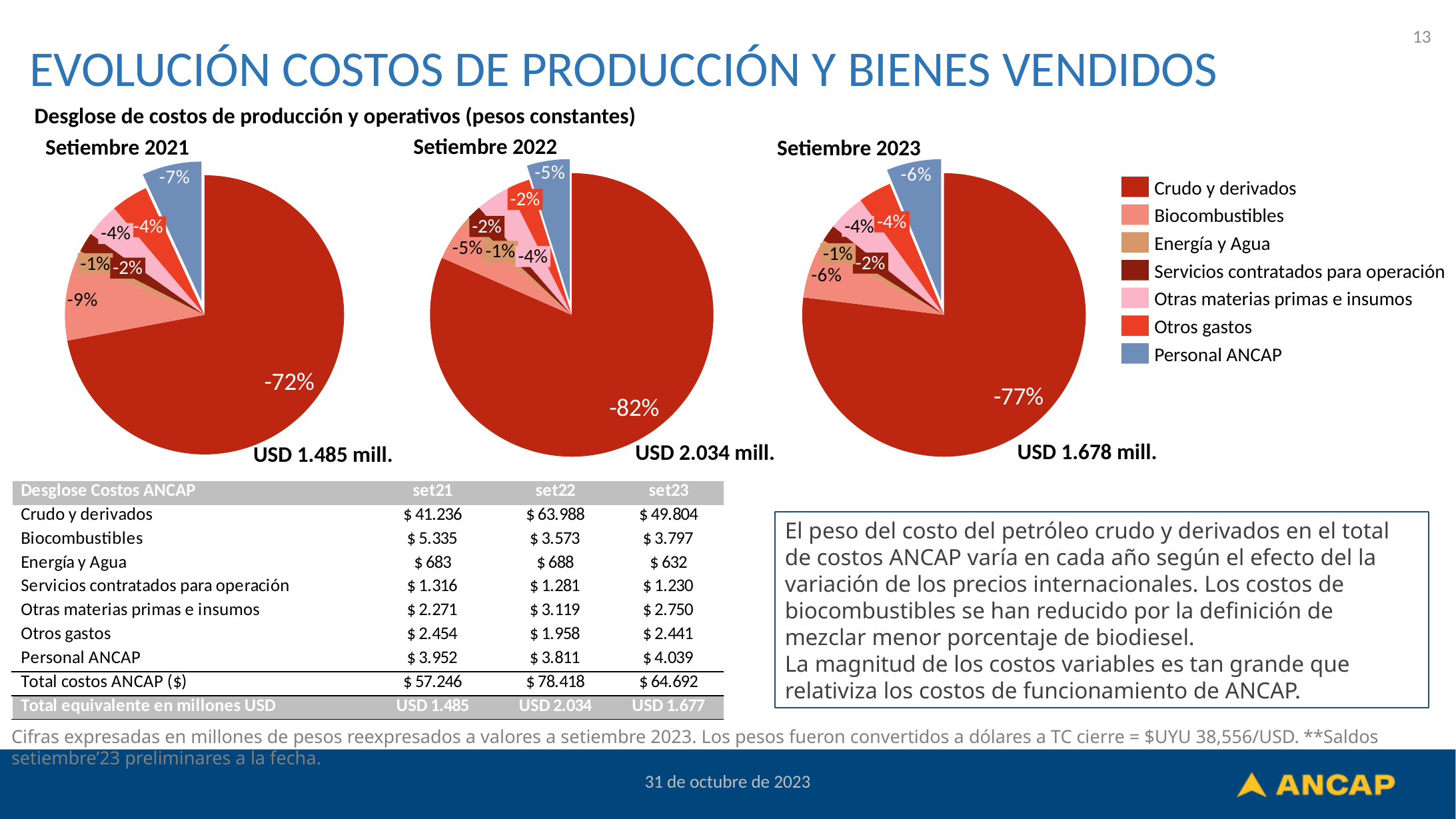
In the Setiembre 2023 pie chart, what percentage label is shown for Personal ANCAP? -6% In the Setiembre 2022 pie chart, what percentage label is shown for Crudo y derivados? -82% In the Setiembre 2021 pie chart, what percentage label is shown for Crudo y derivados? -72% How many categories does the legend list for the pie charts? 7 Which pie chart shows a larger share for Crudo y derivados, Setiembre 2021 or Setiembre 2022? Setiembre 2022 What type of chart is used to show the breakdown of costs for each year? Pie chart What total in USD is shown below the Setiembre 2022 pie chart? USD 2.034 mill. In the Setiembre 2023 pie chart, what percentage label is shown for Crudo y derivados? -77% In the Setiembre 2022 pie chart, which category has the largest slice? Crudo y derivados In the Setiembre 2021 pie chart, which category has the smallest slice? Energía y Agua Which legend category is shown in blue in the pie charts? Personal ANCAP In the Setiembre 2021 pie chart, what percentage label is shown for Biocombustibles? -9%